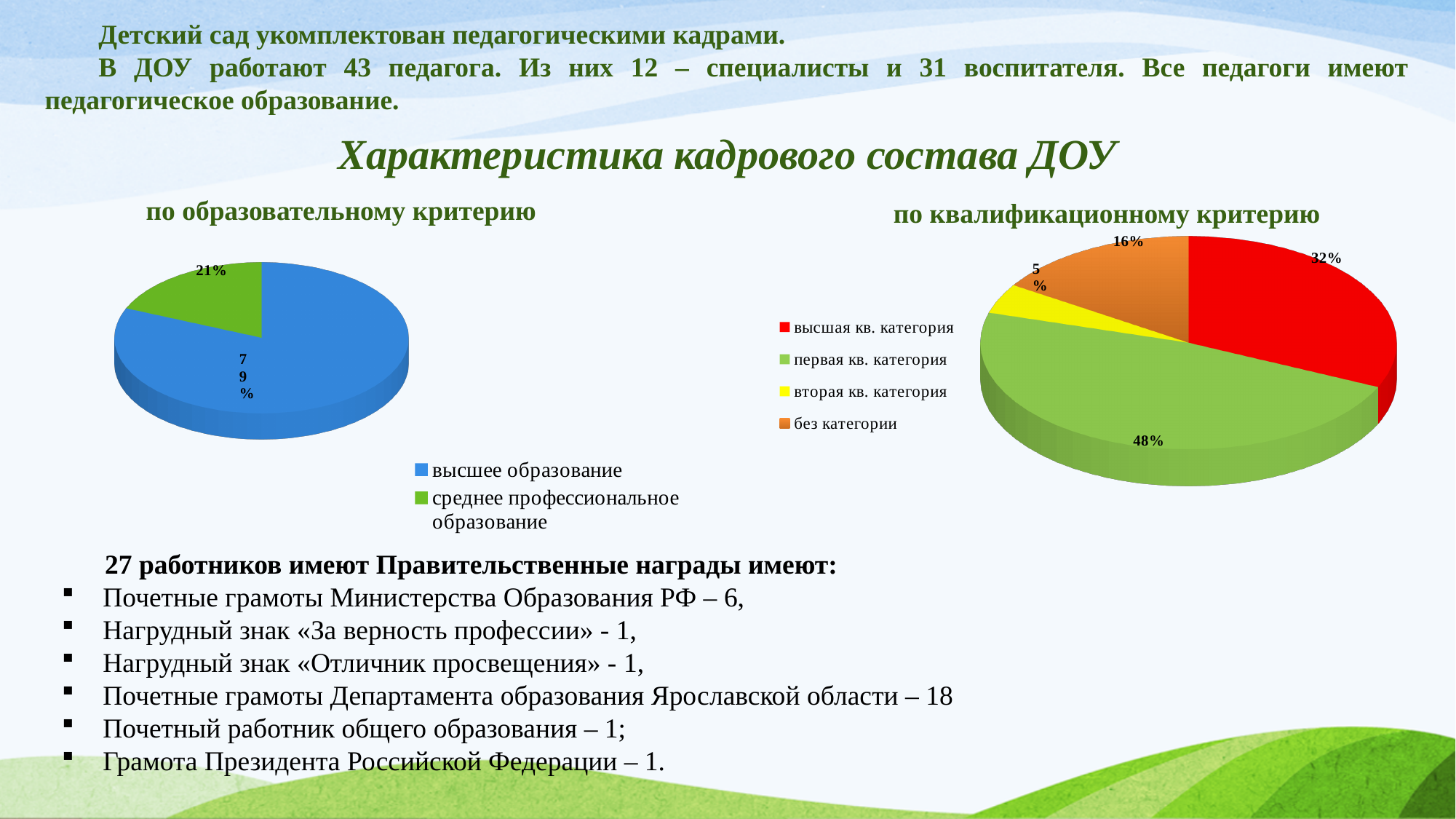
In the chart "по квалификационному критерию", how many categories does the legend list? 4 In the chart "по квалификационному критерию", what share of staff is без категории? 16% In the chart "по образовательному критерию", which category has the larger share? высшее образование In the chart "по квалификационному критерию", which is larger: высшая кв. категория or без категории? высшая кв. категория In the chart "по образовательному критерию", how many categories does the legend list? 2 In the chart "по образовательному критерию", what share of staff has высшее образование? 79% What type of chart is used for "по квалификационному критерию"? pie chart In the chart "по квалификационному критерию", what share of staff has высшая кв. категория? 32% In the chart "по квалификационному критерию", which category has the smallest share? вторая кв. категория In the chart "по образовательному критерию", what is the difference in percentage points between высшее образование and среднее профессиональное образование? 58 In the chart "по образовательному критерию", what share of staff has среднее профессиональное образование? 21% In the chart "по квалификационному критерию", what share of staff has первая кв. категория? 48%